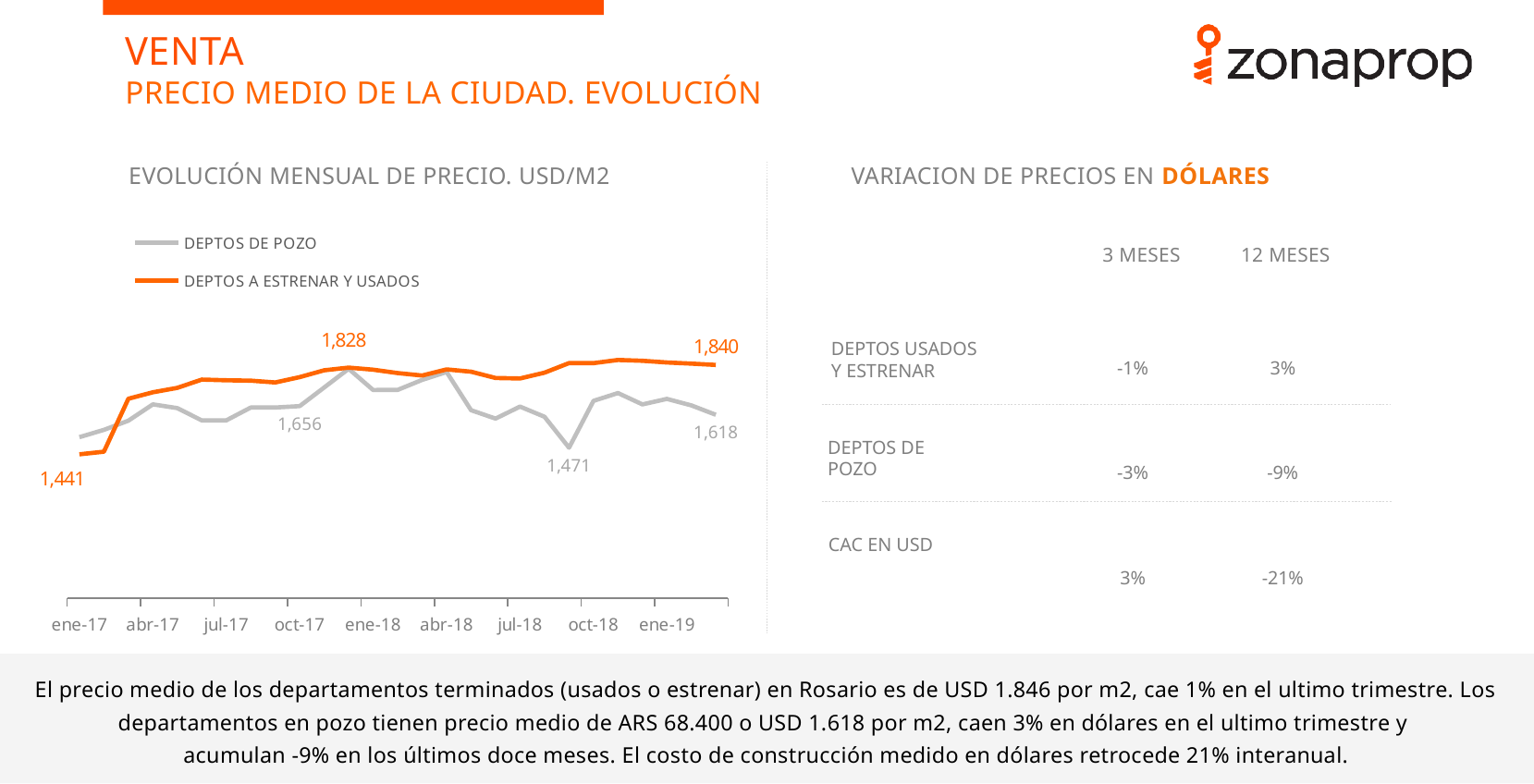
What is the lowest value labelled on the DEPTOS DE POZO line? 1,471 What is the value labelled for DEPTOS A ESTRENAR Y USADOS at ene-17? 1,441 What type of chart is shown under the title EVOLUCIÓN MENSUAL DE PRECIO. USD/M2? Line chart Does the DEPTOS A ESTRENAR Y USADOS line rise or fall overall from ene-17 to ene-19? Rise At ene-19, which series has the higher value: DEPTOS DE POZO or DEPTOS A ESTRENAR Y USADOS? DEPTOS A ESTRENAR Y USADOS What colour is the DEPTOS DE POZO line in the chart? Gray How many series does the legend of the line chart list? 2